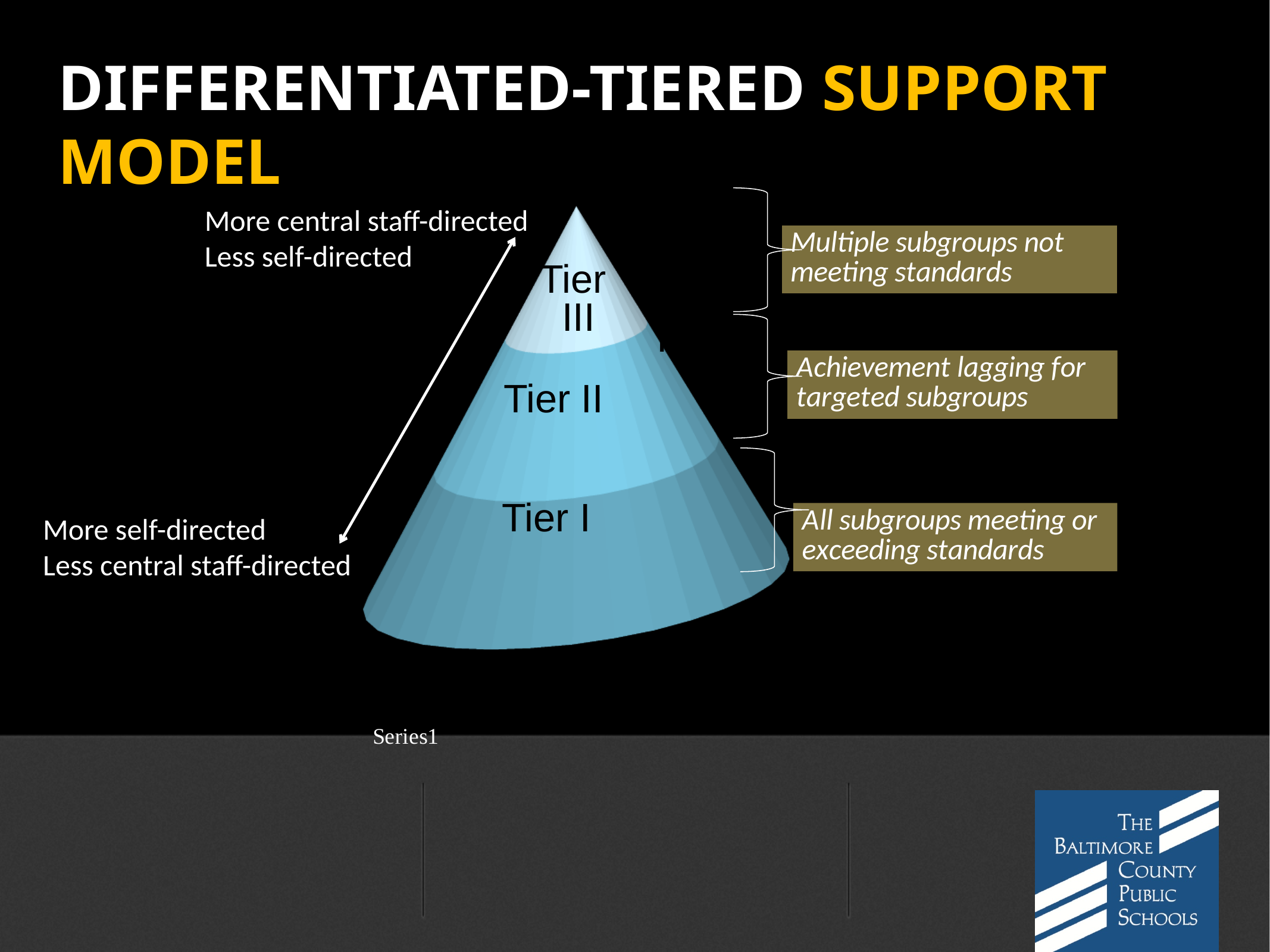
How many tiers (segments) are shown in the cone chart? 3 Which tier occupies the largest segment of the cone? Tier I Which tier is at the bottom of the cone? Tier I Is the segment for Tier I larger or smaller than the segment for Tier III? larger Which tier is at the top of the cone? Tier III Which tier occupies the smallest segment of the cone? Tier III What kind of chart is shown on the slide? a 3D cone chart